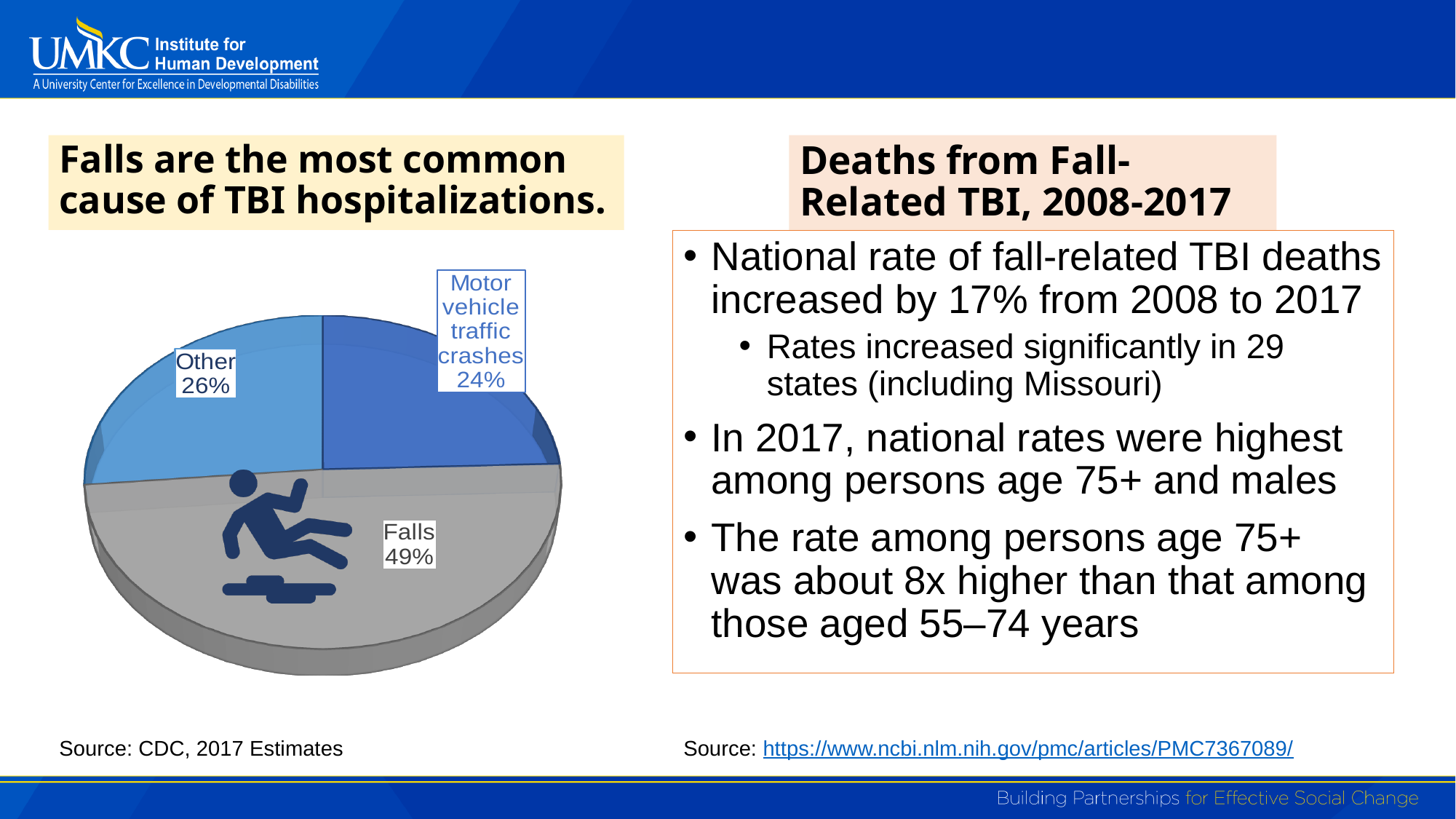
Which slice is larger, Falls or Motor vehicle traffic crashes? Falls What is the title above the pie chart? Falls are the most common cause of TBI hospitalizations. What source is cited below the pie chart? CDC, 2017 Estimates Which category has the smallest slice in the pie chart? Motor vehicle traffic crashes What share of TBI hospitalizations is attributed to Other in the pie chart? 26% What kind of chart is shown on the slide? Pie chart What is the difference in percentage points between the Other slice and the Motor vehicle traffic crashes slice? 2 What share of TBI hospitalizations is attributed to Falls in the pie chart? 49% What is the difference in percentage points between the Falls slice and the Other slice? 23 What share of TBI hospitalizations is attributed to Motor vehicle traffic crashes in the pie chart? 24% How many slices does the pie chart have? 3 Which category has the largest slice in the pie chart? Falls